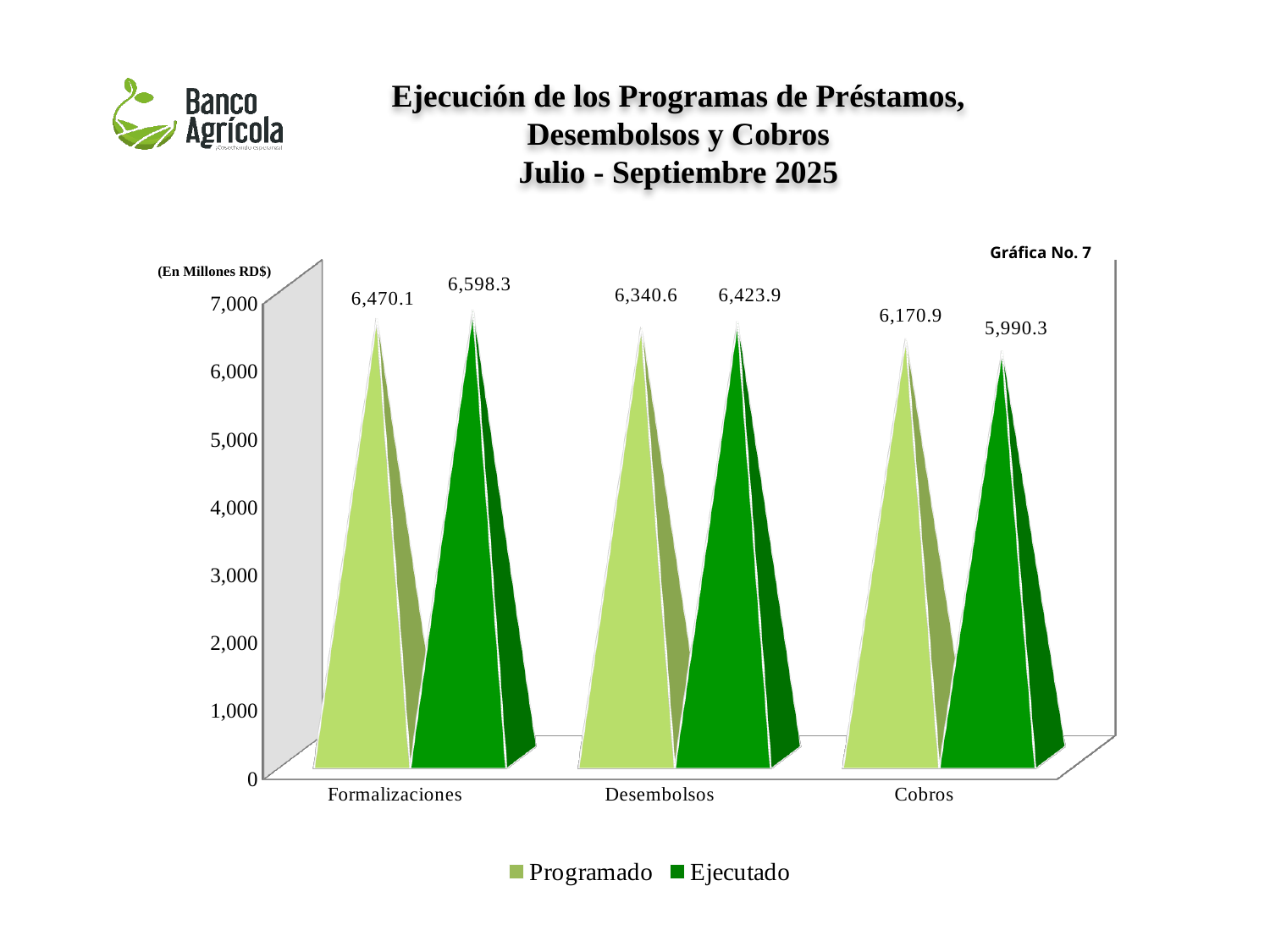
What is the Ejecutado value for Desembolsos? 6,423.9 What is the difference between the Programado and Ejecutado values for Cobros? 180.6 For Cobros, which is larger: Programado or Ejecutado? Programado How many categories are shown on the x axis? 3 Is the Ejecutado value for Formalizaciones greater or less than 6,000? greater How many series does the legend list? 2 What is the Ejecutado value for Cobros? 5,990.3 What unit is stated for the values in the chart? En Millones RD$ What is the Programado value for Formalizaciones? 6,470.1 What is the difference between the Ejecutado and Programado values for Formalizaciones? 128.2 Which category has the highest Ejecutado value? Formalizaciones Which category has the lowest Programado value? Cobros